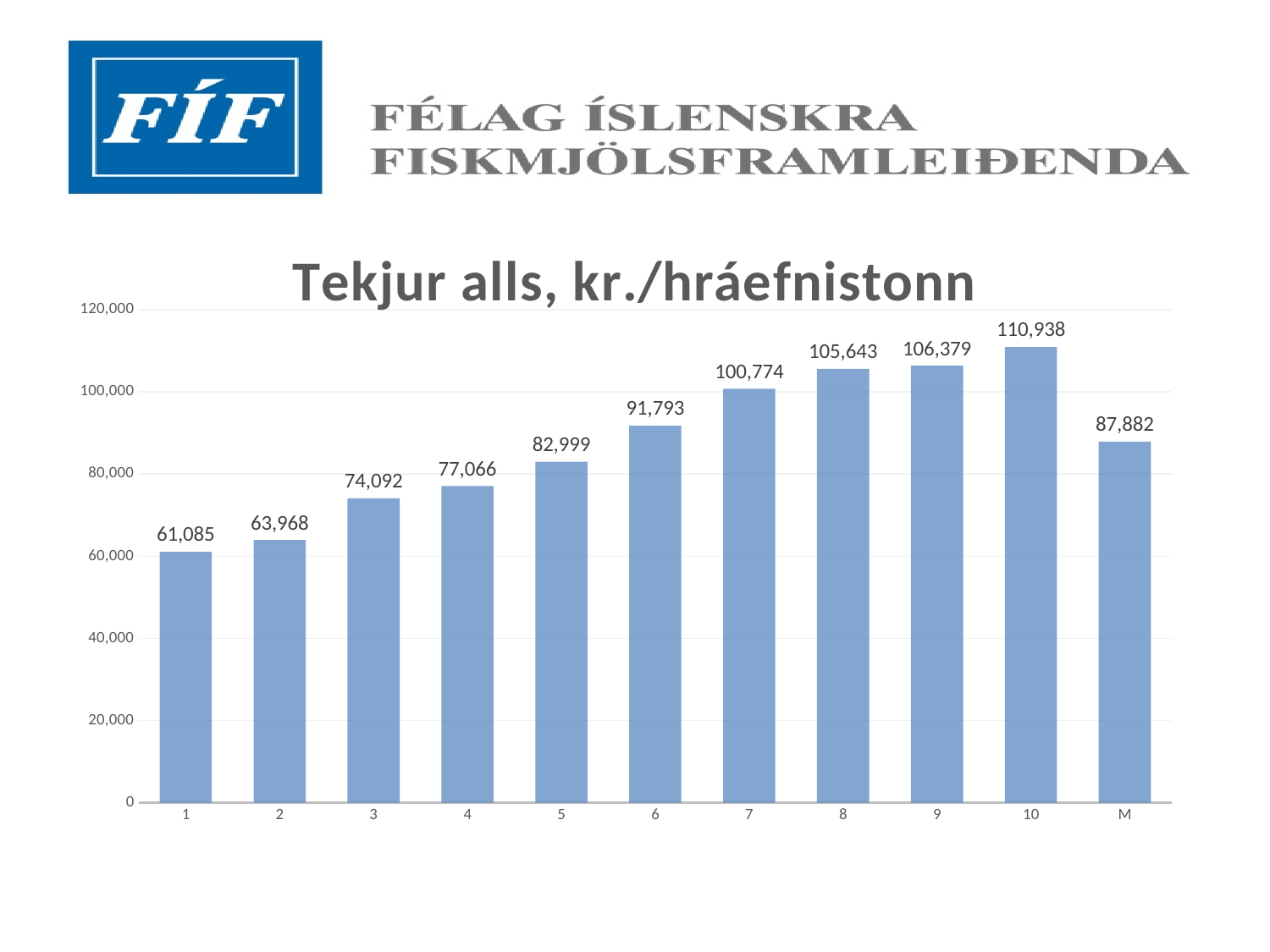
What is the title of the chart? Tekjur alls, kr./hráefnistonn Which is larger, the value for category 4 or the value for category M? M What is the value for category M? 87,882 What kind of chart is shown? bar chart What is the value for category 1? 61,085 How many categories are shown on the x axis? 11 Which category has the highest value? 10 What is the difference between the values for category 6 and category 5? 8,794 What is the difference between the values for category 10 and category 1? 49,853 Which category has the lowest value? 1 Is the value for category 3 greater or less than 80,000? less What is the value for category 7? 100,774